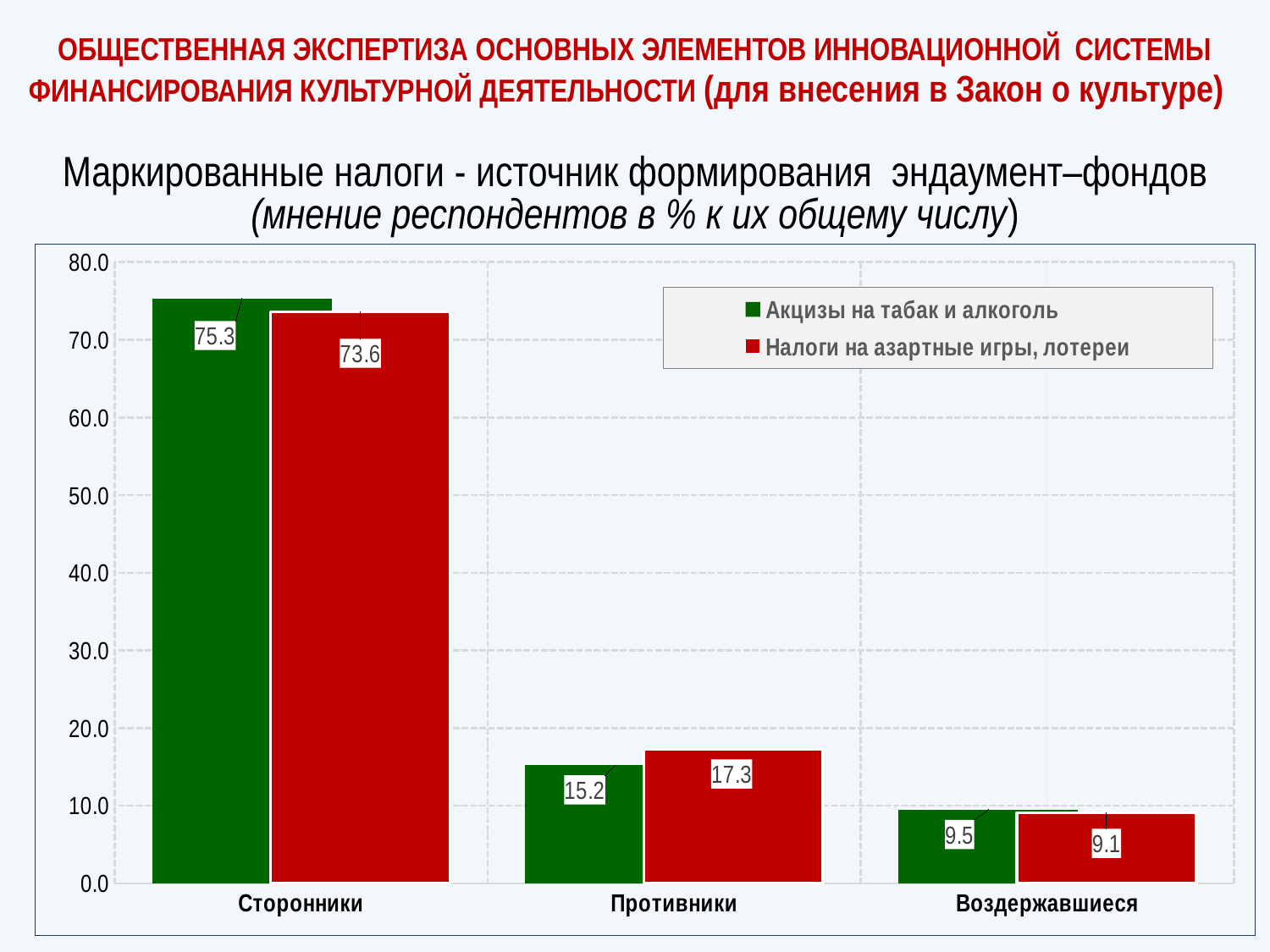
What kind of chart is shown on the slide? bar chart What is the value for Воздержавшиеся in the series Акцизы на табак и алкоголь? 9.5 What is the value for Противники in the series Налоги на азартные игры, лотереи? 17.3 Which colour represents the series Налоги на азартные игры, лотереи? red What is the value for Сторонники in the series Акцизы на табак и алкоголь? 75.3 What is the difference between the Сторонники values for Акцизы на табак и алкоголь and Налоги на азартные игры, лотереи? 1.7 How many series does the legend list? 2 Which category has the lowest value in the series Акцизы на табак и алкоголь? Воздержавшиеся Which category has the highest value in the series Налоги на азартные игры, лотереи? Сторонники For Противники, which series has the larger value: Акцизы на табак и алкоголь or Налоги на азартные игры, лотереи? Налоги на азартные игры, лотереи How many categories are shown on the x axis? 3 Is the value for Противники in the series Акцизы на табак и алкоголь greater or less than 20.0? less